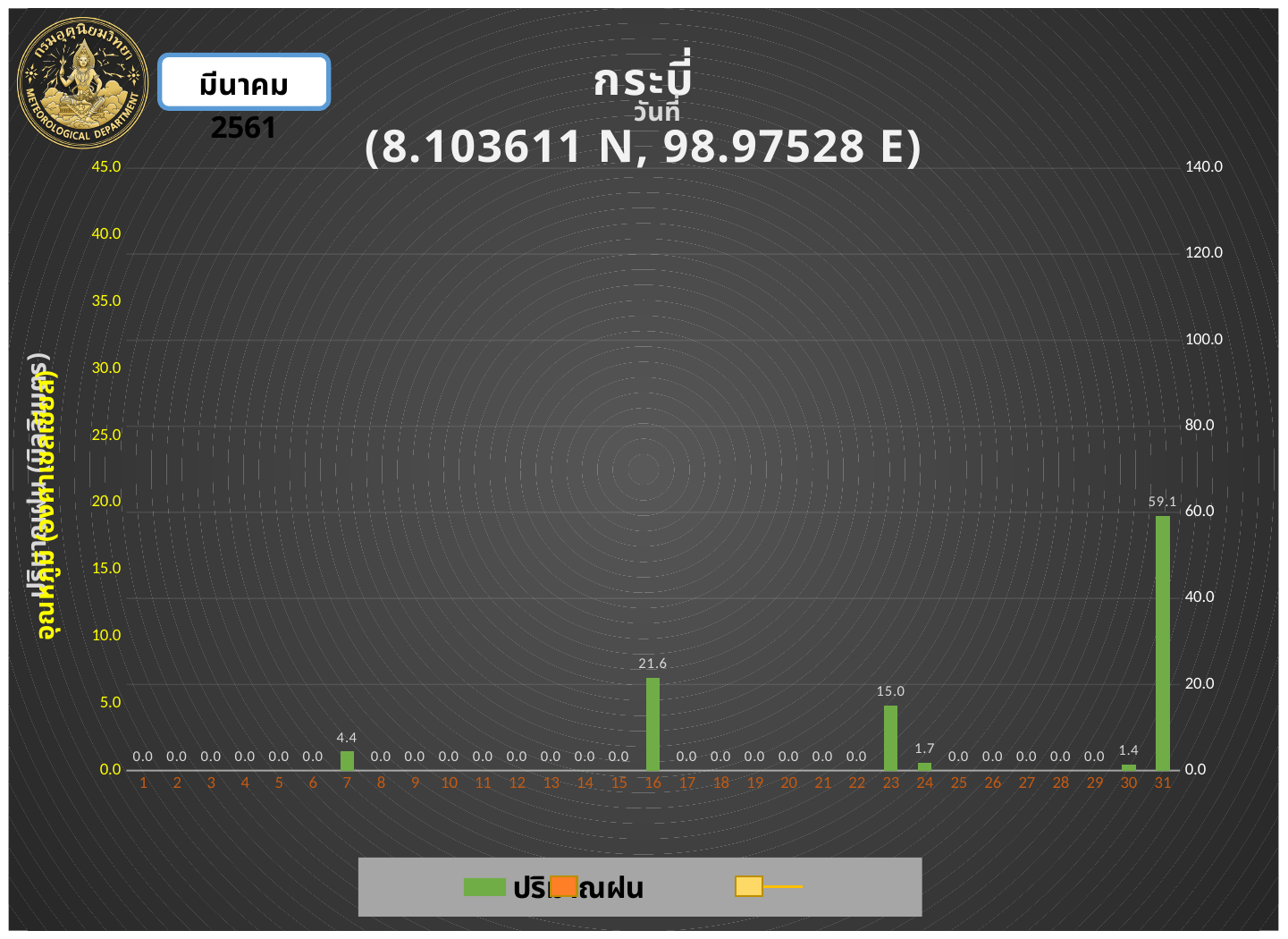
What is the value for day 31? 59.1 What is the value for day 30? 1.4 What is the value for day 16? 21.6 Which has the larger value, day 24 or day 30? day 24 What is the difference between the values for day 16 and day 23? 6.6 What is the value for day 23? 15.0 What is the value for day 24? 1.7 What kind of chart is this? bar chart Which day has the highest value? 31 What is the difference between the values for day 31 and day 16? 37.5 How many days are shown on the x axis? 31 What is the value for day 7? 4.4